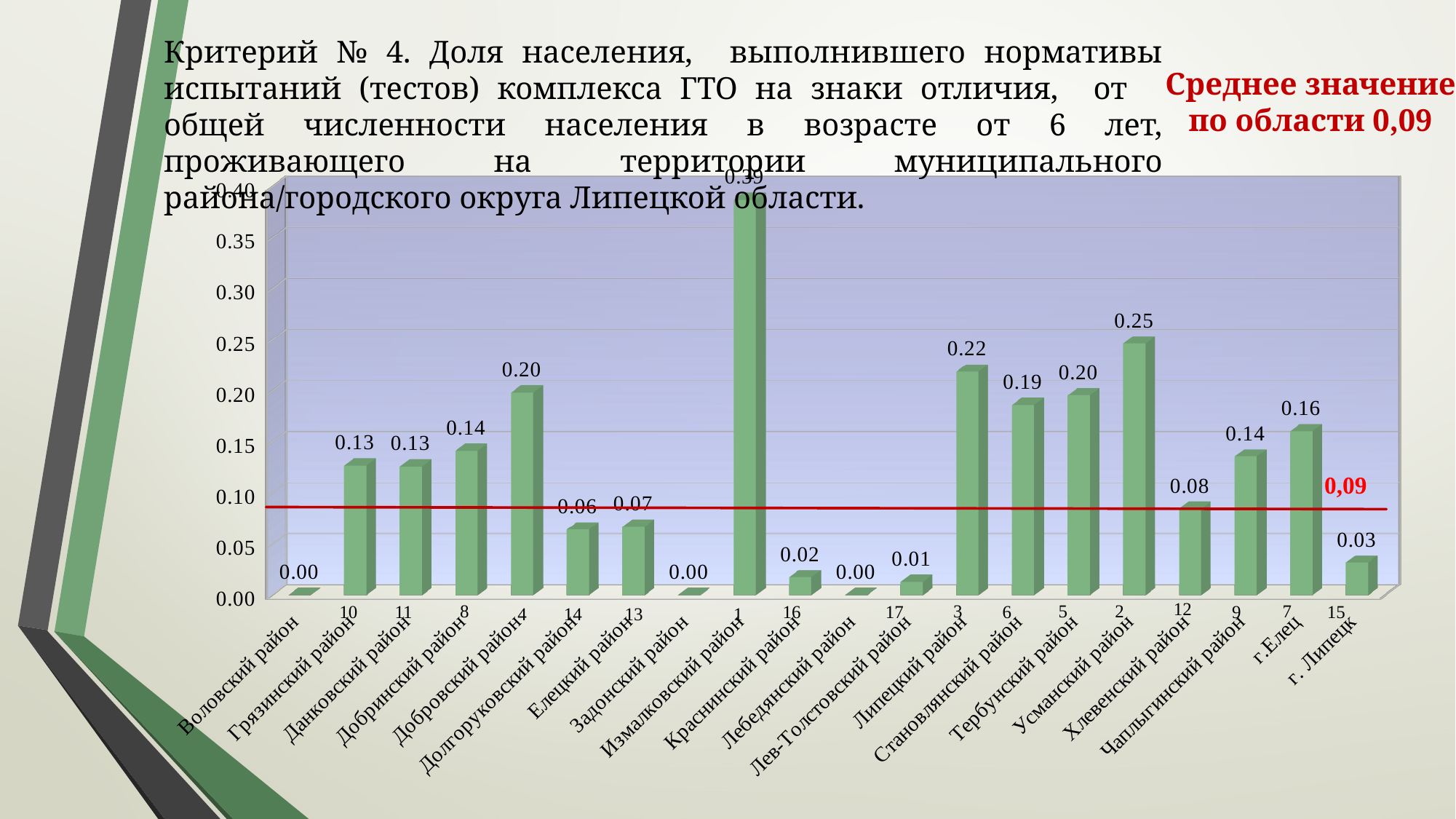
What is the difference between the values for Усманский район and Липецкий район? 0.03 Which is larger, the value for Добровский район or the value for Долгоруковский район? Добровский район How many categories are shown on the x axis? 20 Which category has the highest value? Измалковский район What is the value for Липецкий район? 0.22 Is the value for Измалковский район greater or less than 0.35? greater What is the value for г. Липецк? 0.03 What value does the red horizontal line on the chart mark? 0,09 What kind of chart is shown on the slide? bar chart What is the value for Хлевенский район? 0.08 What is the value for Усманский район? 0.25 What is the difference between the values for г.Елец and Чаплыгинский район? 0.02